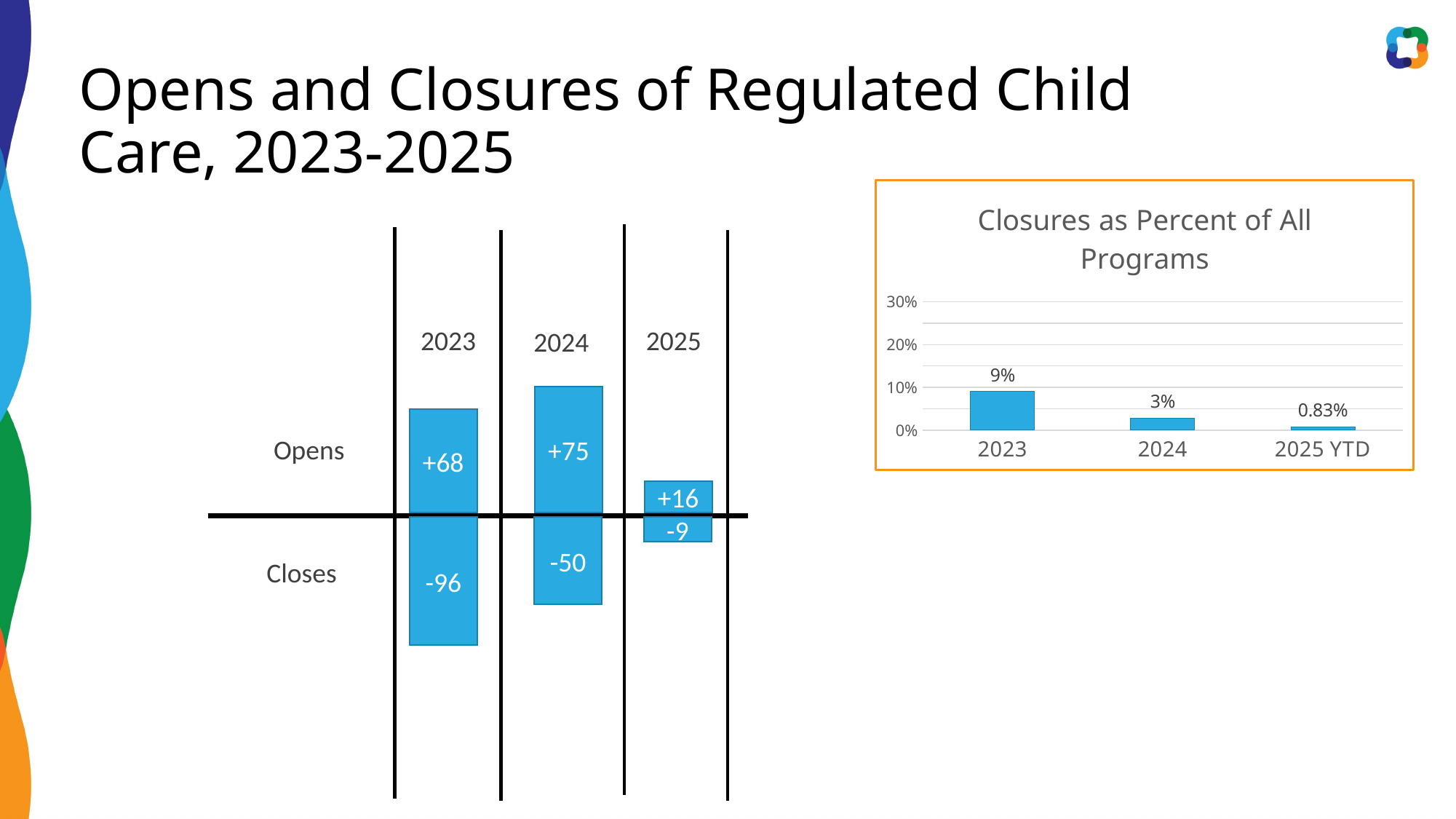
In the Closures as Percent of All Programs chart, what is the value for 2024? 3% In the Closures as Percent of All Programs chart, do the values rise or fall from 2023 to 2025 YTD? fall In the Opens and Closes chart on the left, which year has the largest number of Closes? 2023 In the Opens and Closes chart on the left, what is the value for Opens in 2023? +68 What kind of chart is the Closures as Percent of All Programs chart? bar chart In the Opens and Closes chart on the left, which year has the highest number of Opens? 2024 In the Opens and Closes chart on the left, what is the value for Closes in 2024? -50 In the Opens and Closes chart on the left, what is the difference between Opens and Closes in 2024? 25 In the Opens and Closes chart on the left, how many years are shown? 3 In the Closures as Percent of All Programs chart, which category has the highest value? 2023 In the Opens and Closes chart on the left, what is the value for Opens in 2025? +16 In the Closures as Percent of All Programs chart, what is the value for 2025 YTD? 0.83%